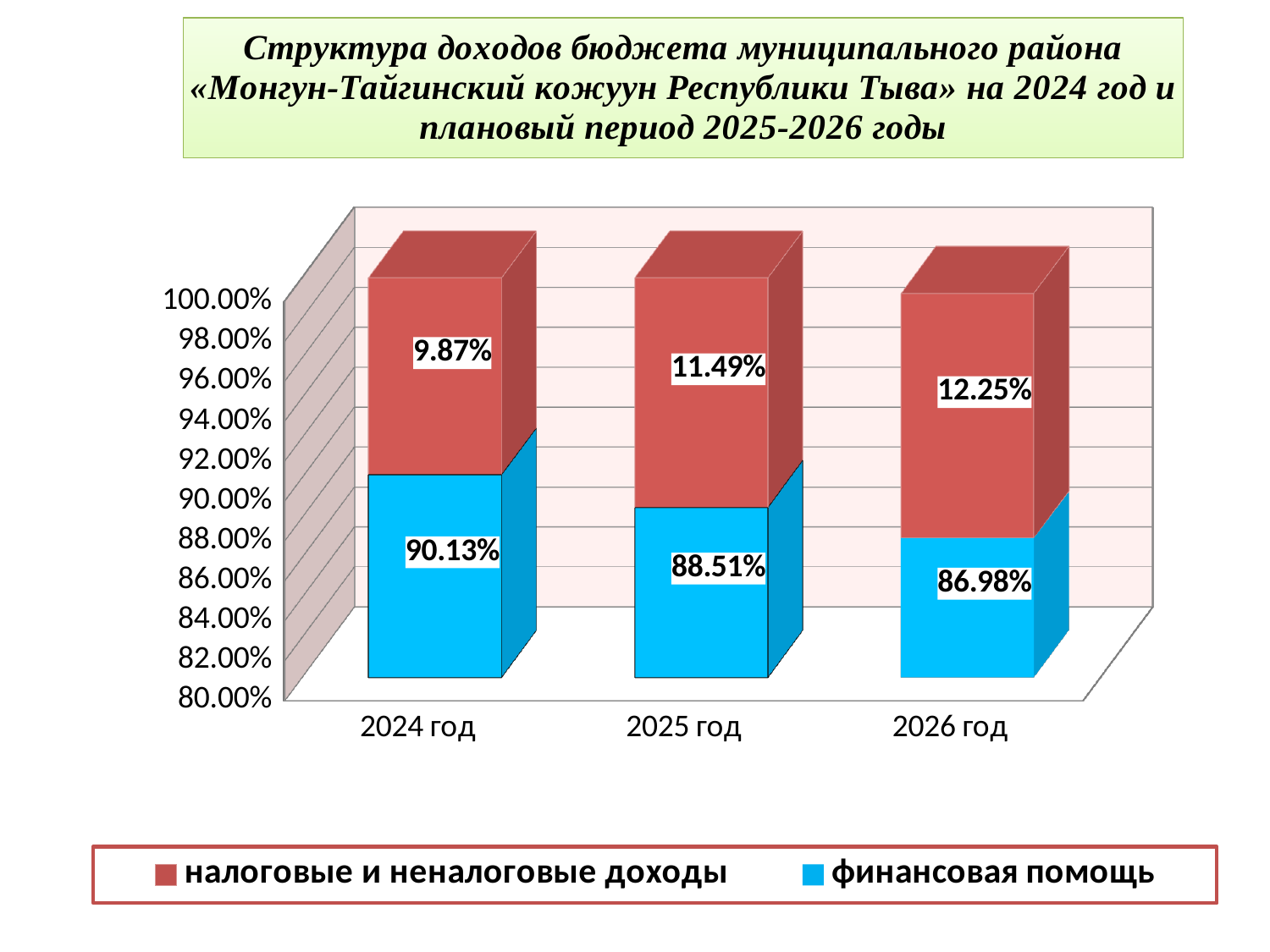
How many years (categories) are shown on the x axis? 3 Which is larger: финансовая помощь in 2024 год or in 2025 год? 2024 год What is the value for финансовая помощь in 2026 год? 86.98% In which year is the share of финансовая помощь lowest? 2026 год What is the value for налоговые и неналоговые доходы in 2024 год? 9.87% What is the difference between the финансовая помощь values for 2024 год and 2026 год? 3.15% What is the value for финансовая помощь in 2025 год? 88.51% In which year is the share of налоговые и неналоговые доходы highest? 2026 год What is the difference between the налоговые и неналоговые доходы values for 2026 год and 2024 год? 2.38% How many series does the legend list? 2 Does the share of налоговые и неналоговые доходы rise or fall from 2024 год to 2026 год? Rise What kind of chart is shown on the slide? Stacked bar chart